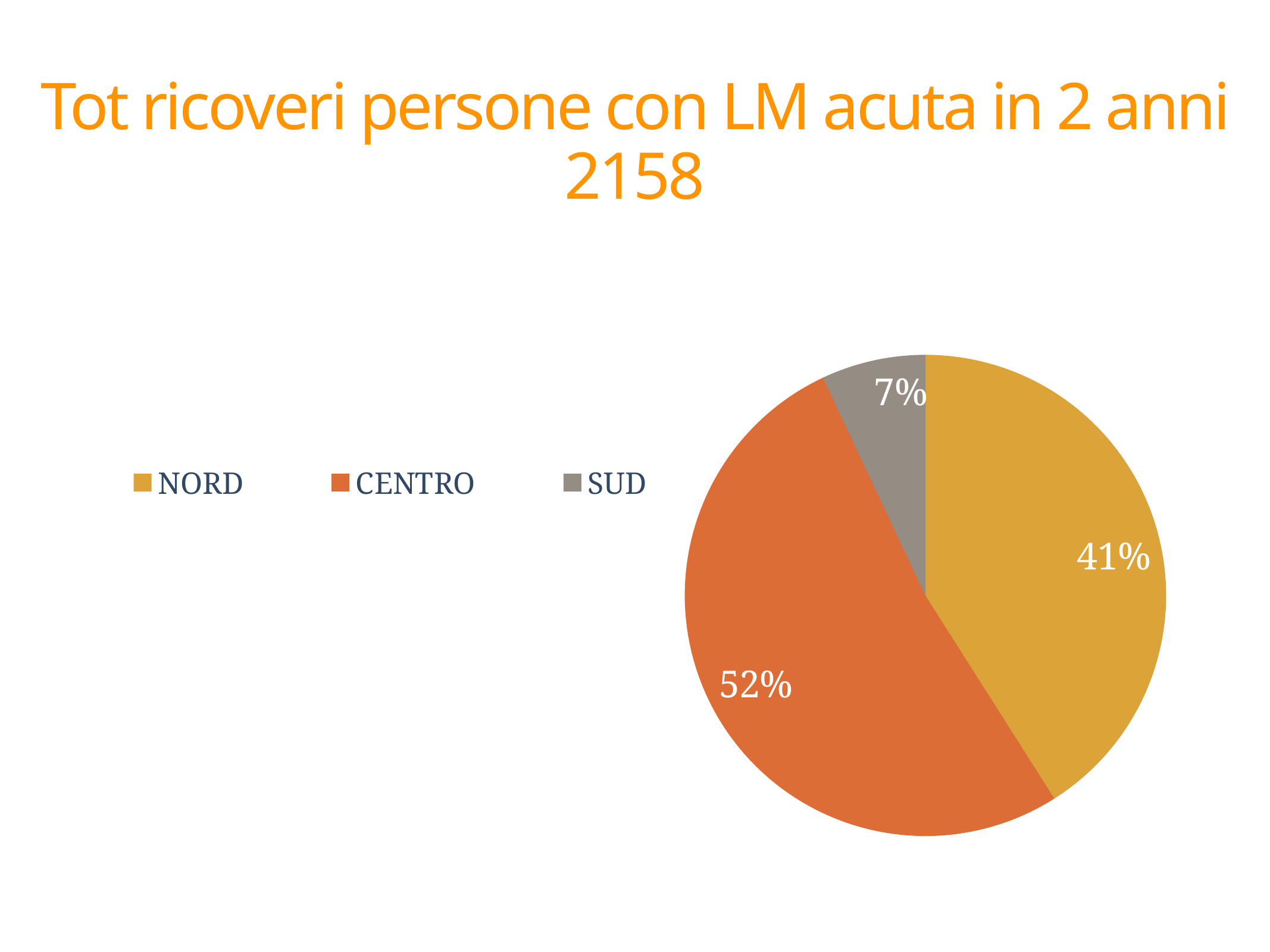
How many categories does the pie chart show? 3 What percentage of the pie does SUD represent? 7% What percentage of the pie does CENTRO represent? 52% Which category has the largest share of the pie? CENTRO What colour is the slice for CENTRO? orange What percentage of the pie does NORD represent? 41% What is the difference in percentage points between NORD and SUD? 34 What is the difference in percentage points between CENTRO and NORD? 11 Which is larger, the share for NORD or the share for SUD? NORD What is the title of the chart on the slide? Tot ricoveri persone con LM acuta in 2 anni 2158 Which category has the smallest share of the pie? SUD What type of chart is shown on the slide? pie chart